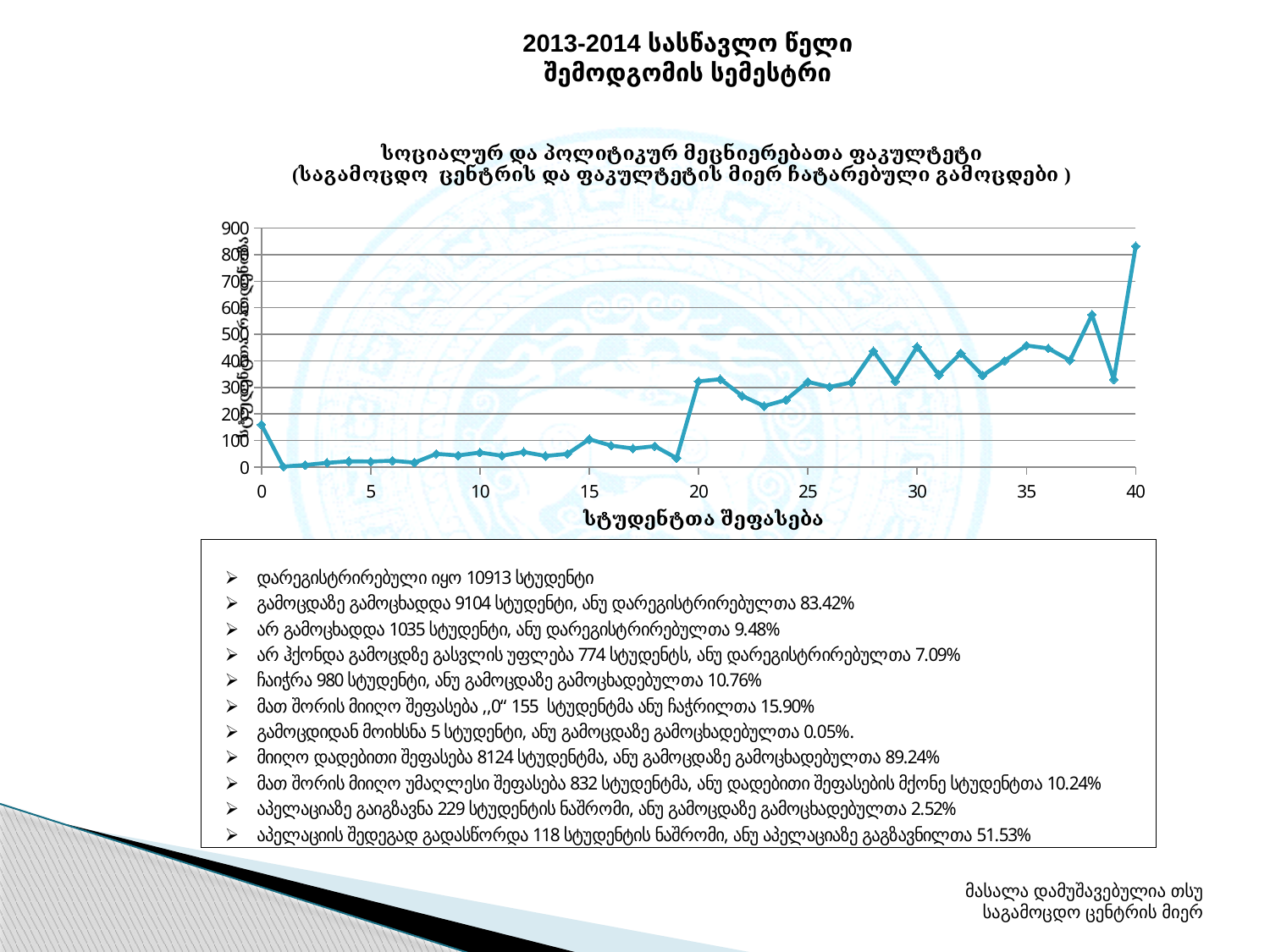
At which x-axis score does the line reach its highest value? 40 Is the value at score 39 greater or less than 400? less Which has the larger value, score 38 or score 40? score 40 Is the value at score 10 greater or less than 100? less Is the value at score 0 greater or less than 100? greater What kind of chart is shown on the slide? line chart Does the line generally rise or fall between scores 20 and 40? rise What is the title of the x axis? სტუდენტთა შეფასება Which has the larger value, score 19 or score 20? score 20